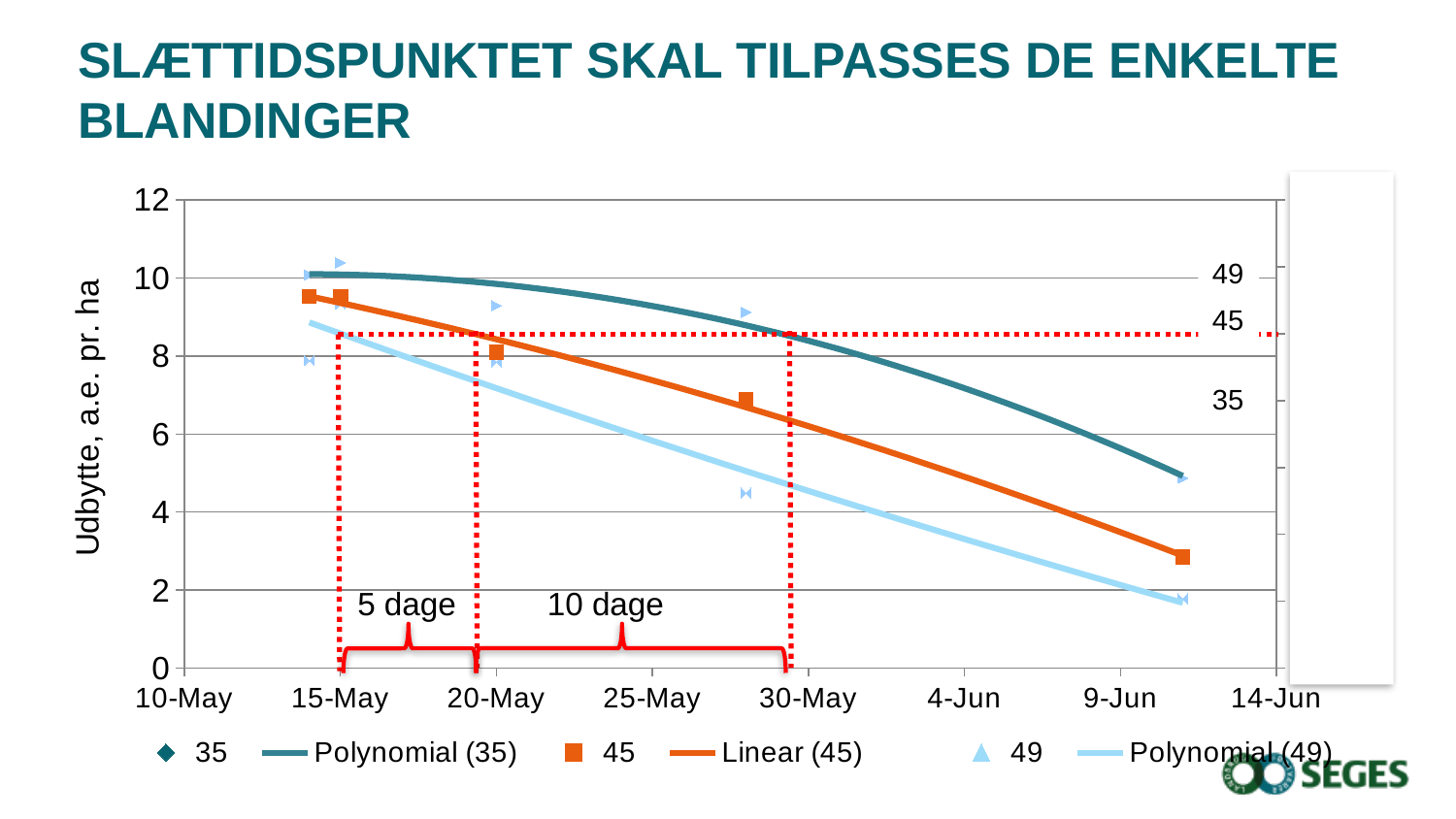
Near 12-Jun, which series has the larger value, 35 or 45? 35 What is the highest value shown on the vertical axis? 12 Is the value of the 45 series point near 15-May greater or less than 8? greater Is the value of the 45 series point near 28-May greater or less than 6? greater How many entries does the chart legend list? 6 Is the value of the 45 series point near 12-Jun greater or less than 4? less What kind of chart is shown on the slide? Scatter chart with trendlines How many date ticks are labelled on the horizontal axis? 8 Do the yield values for the series rise or fall as the date moves from May to June? Fall Near 28-May, which series has the larger value, 45 or 49? 45 What is the label of the vertical axis? Udbytte, a.e. pr. ha